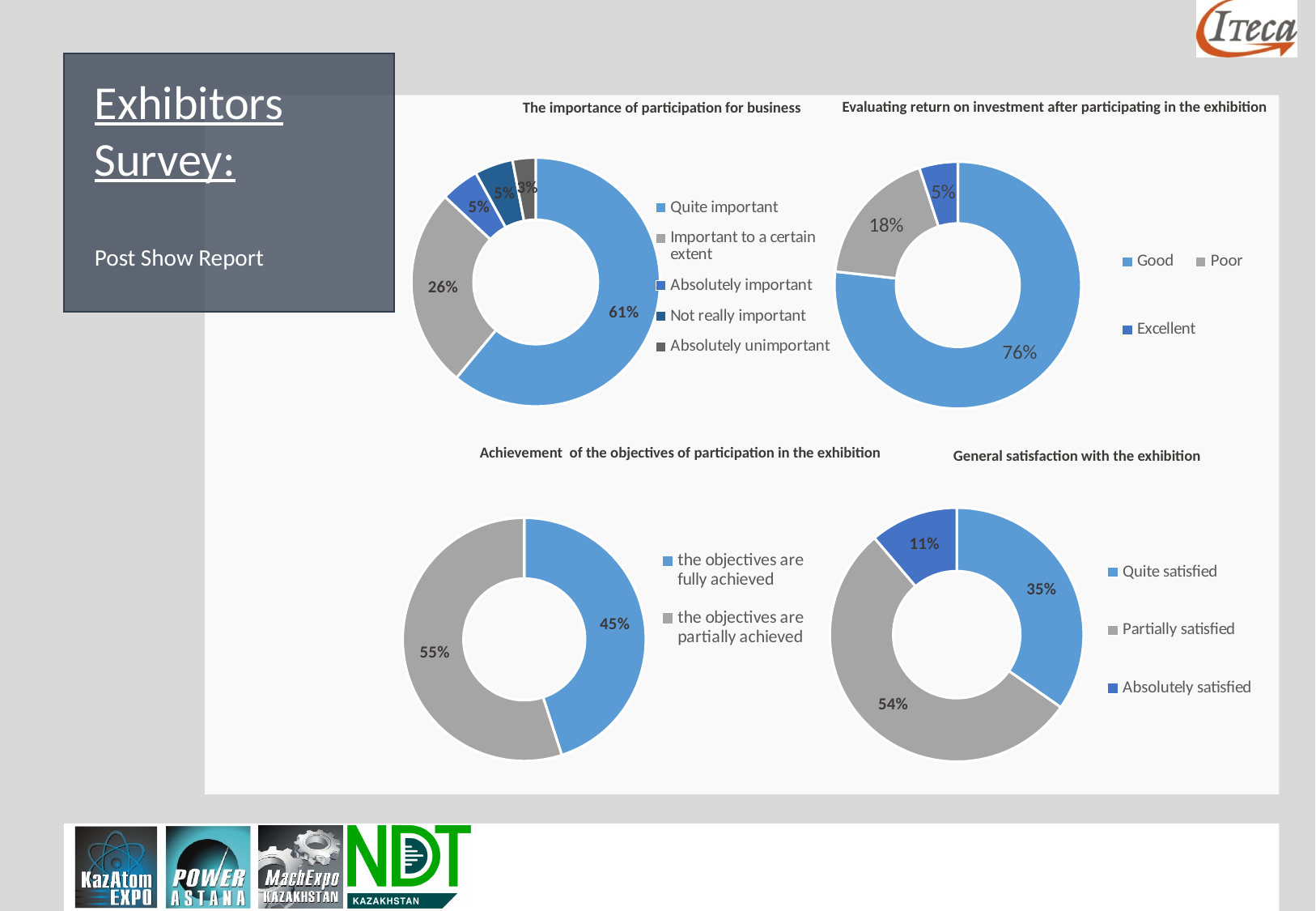
In the chart 'Evaluating return on investment after participating in the exhibition', what is the difference between the Poor and Excellent shares? 13% What type of chart is used for 'General satisfaction with the exhibition'? Doughnut (pie) chart In the chart 'The importance of participation for business', what share of respondents said participation is quite important? 61% In the chart 'The importance of participation for business', which category has the smallest share? Absolutely unimportant How many categories does the legend of 'The importance of participation for business' chart list? 5 In the chart 'Evaluating return on investment after participating in the exhibition', what percentage rated the return as Good? 76% In the chart 'General satisfaction with the exhibition', what percentage were absolutely satisfied? 11% In the chart 'Achievement of the objectives of participation in the exhibition', which is larger: fully achieved or partially achieved? the objectives are partially achieved In the chart 'Evaluating return on investment after participating in the exhibition', which category has the largest share? Good In the chart 'The importance of participation for business', what percentage is shown for 'Important to a certain extent'? 26% In the chart 'General satisfaction with the exhibition', what is the difference between the Partially satisfied and Quite satisfied shares? 19% In the chart 'Achievement of the objectives of participation in the exhibition', what share said the objectives are fully achieved? 45%